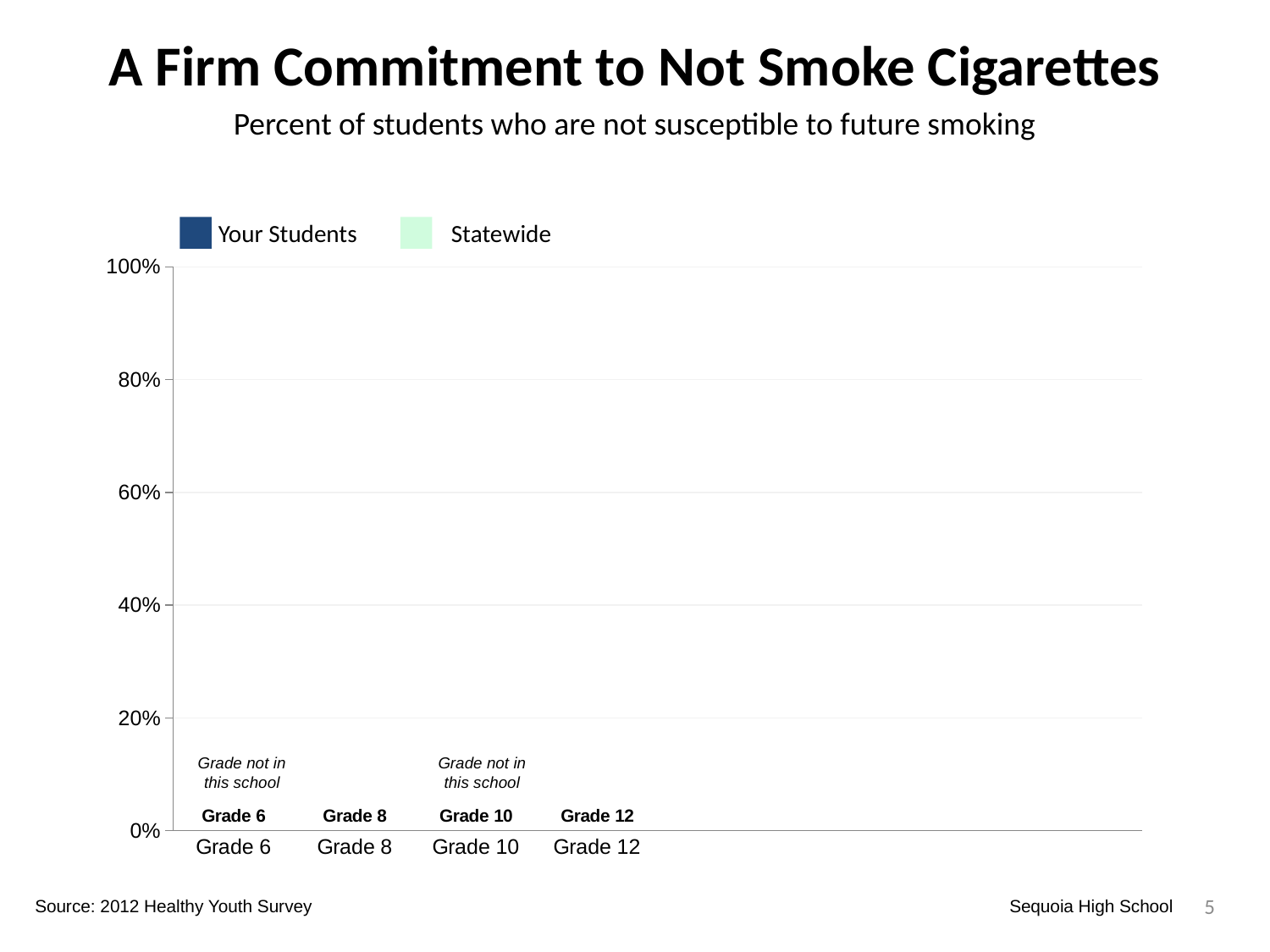
What is the subtitle shown under the chart's main title? Percent of students who are not susceptible to future smoking How many series does the chart's legend list? 2 What is the lowest value shown on the chart's y axis? 0% What are the two series named in the chart's legend? Your Students and Statewide How many grade categories are shown on the x axis of the chart? 4 Which grades on the chart are marked as 'Grade not in this school'? Grade 6 and Grade 10 What is the highest value shown on the chart's y axis? 100%